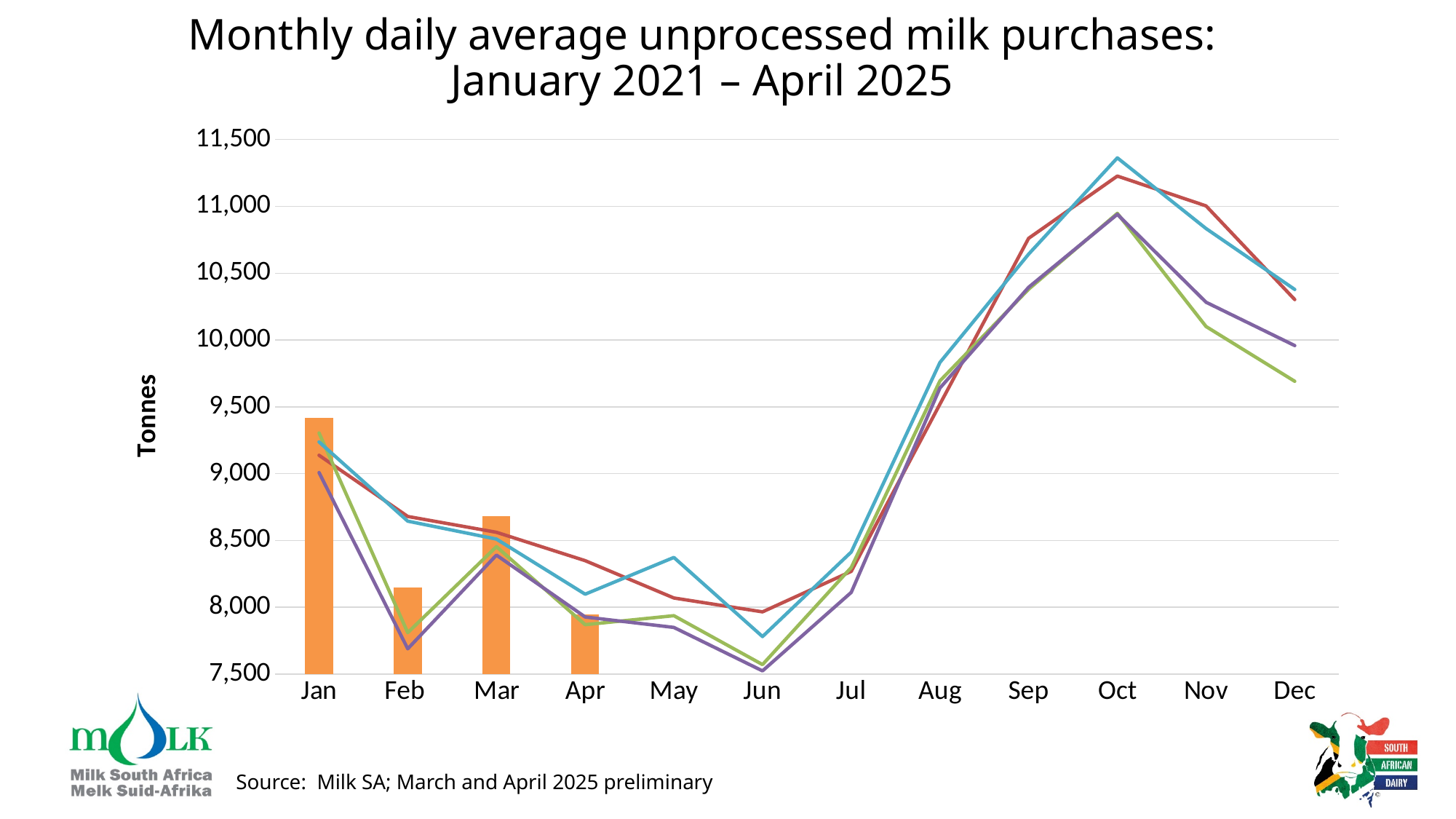
In which month do the line series reach their highest values? Oct What is the title of the chart? Monthly daily average unprocessed milk purchases: January 2021 – April 2025 How many orange bars are plotted on the chart? 4 Is the value of the orange bar for Mar greater or less than 8,500? greater Do the line series rise or fall between Jun and Oct? rise What kind of chart is shown on the slide? A combined bar and line chart Is the value of the orange bar for Feb greater or less than 8,500? less Is the peak value of the blue line in Oct greater or less than 11,000? greater How many months are shown along the x axis of the chart? 12 What is the label on the vertical axis of the chart? Tonnes